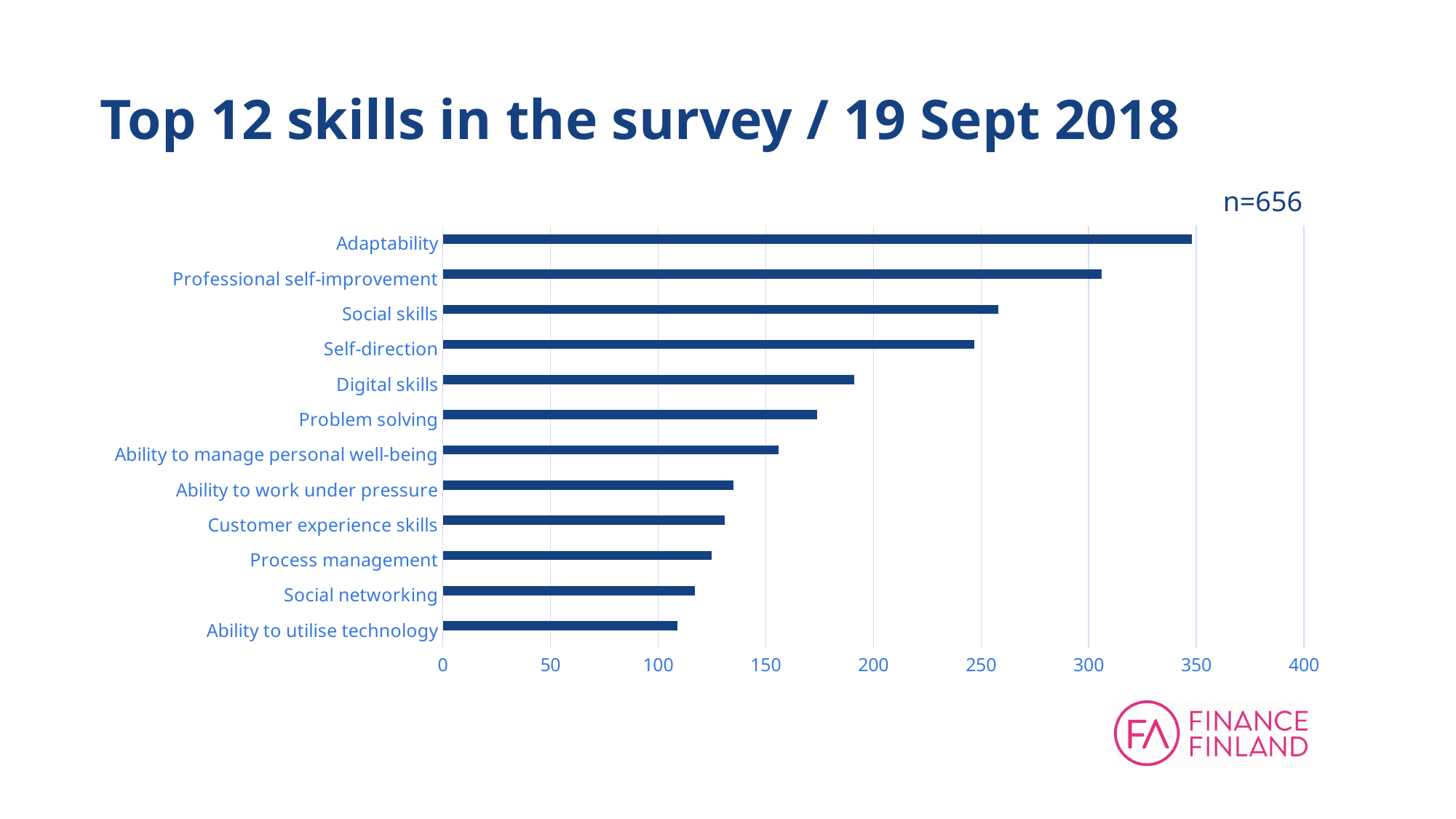
Which has the larger value, Social skills or Ability to manage personal well-being? Social skills Which skill has the highest value in the chart? Adaptability Is the value for Problem solving greater or less than 150? greater What kind of chart is shown on the slide? bar chart What sample size (n) is shown on the slide? n=656 Which has the larger value, Digital skills or Problem solving? Digital skills How many skills are listed in the chart? 12 Is the value for Digital skills greater or less than 200? less Is the value for Adaptability greater or less than 300? greater Which skill has the lowest value in the chart? Ability to utilise technology